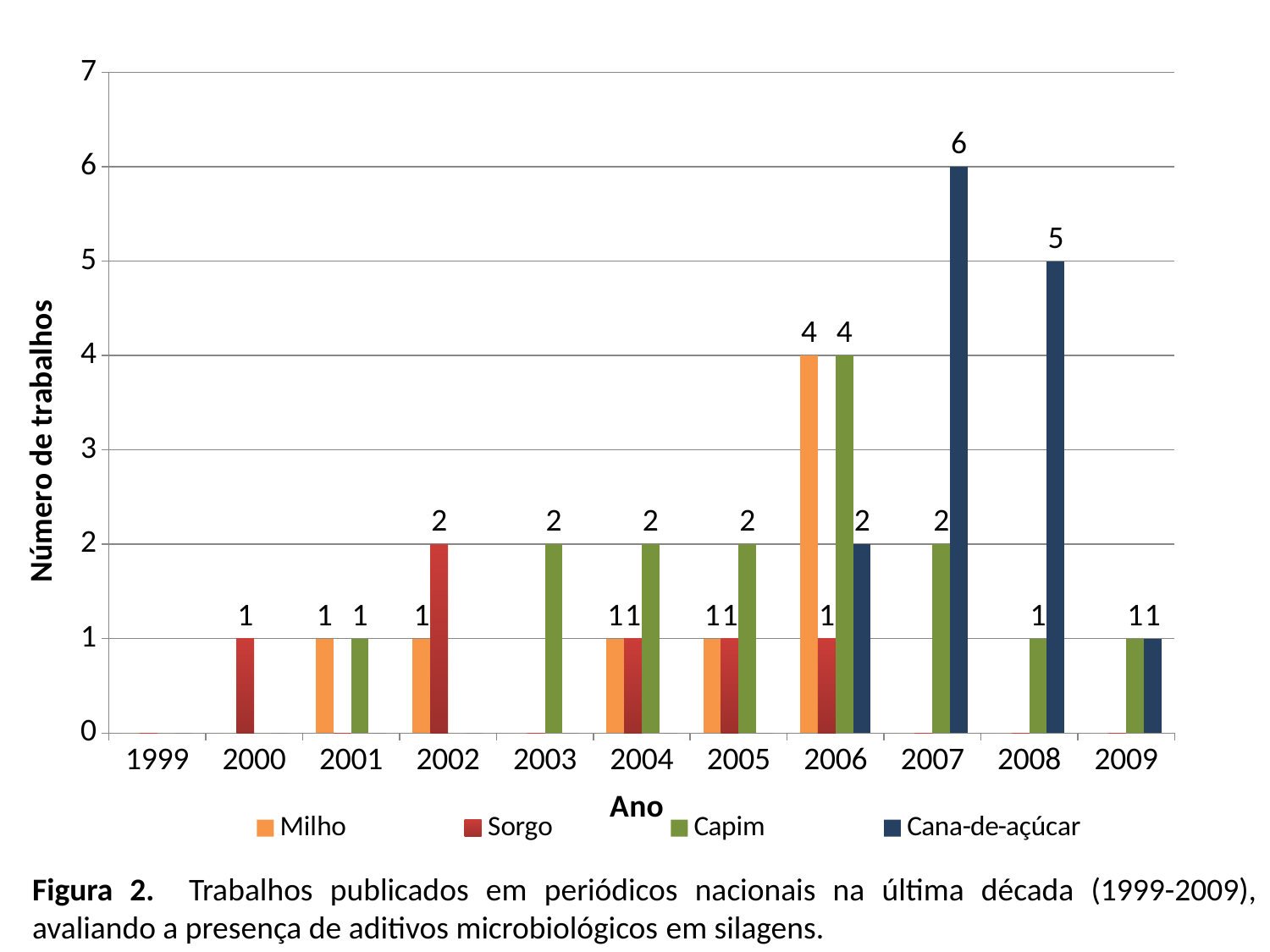
How many years are shown on the x axis? 11 What is the label of the y axis? Número de trabalhos How many series does the legend list? 4 What is the value for Cana-de-açúcar in 2007? 6 What type of chart is shown on the slide? bar chart What is the value for Capim in 2008? 1 What is the difference between the Cana-de-açúcar values in 2007 and 2008? 1 Which is larger in 2006: the value for Capim or the value for Cana-de-açúcar? Capim What is the total of all four series in 2006? 11 In which year does Cana-de-açúcar reach its highest value? 2007 What is the value for Milho in 2006? 4 What is the value for Sorgo in 2002? 2